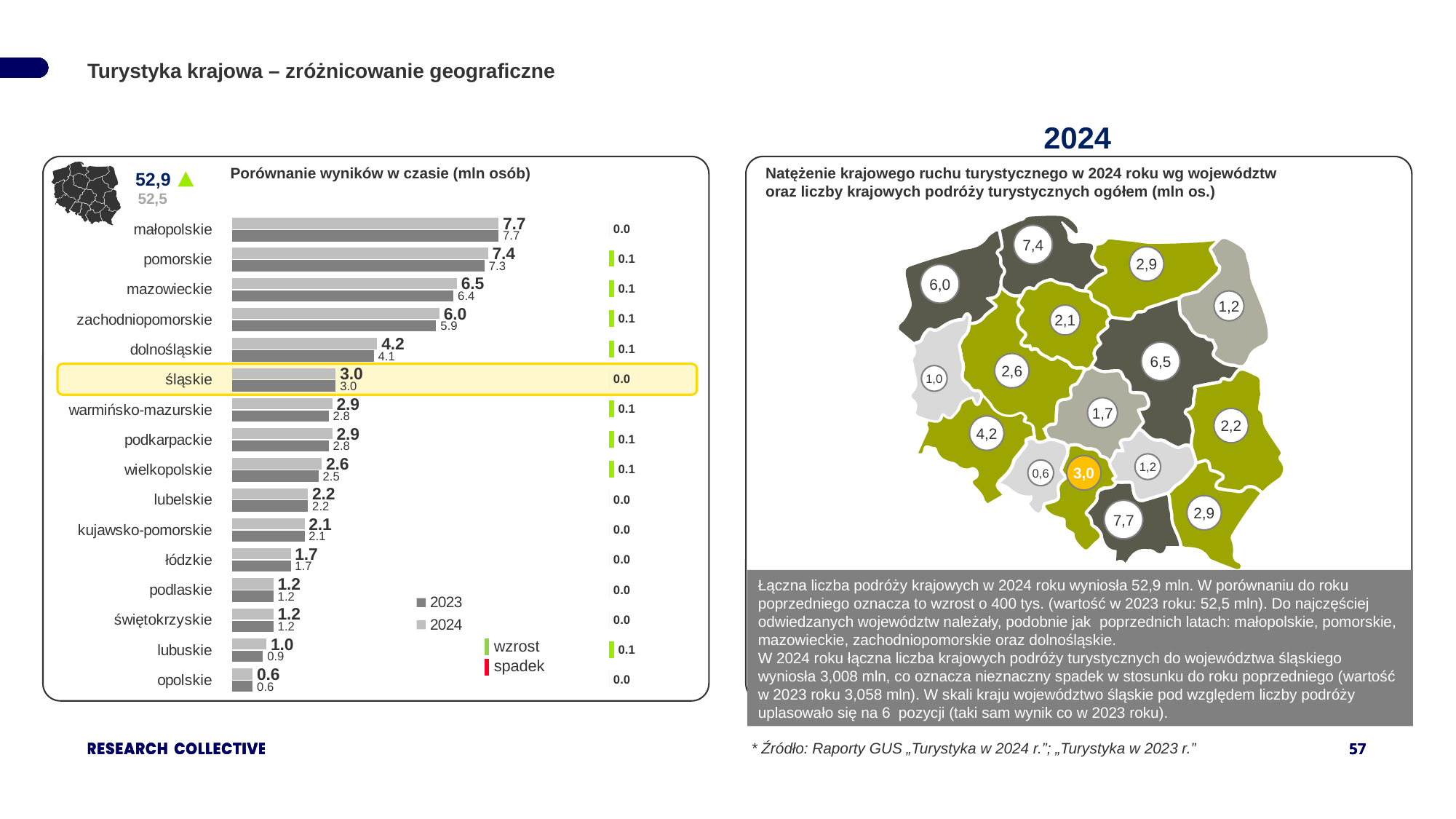
In the bar chart 'Porównanie wyników w czasie (mln osób)', what is the 2024 value for dolnośląskie? 4.2 In the bar chart 'Porównanie wyników w czasie (mln osób)', which voivodeship has the lowest 2024 value? opolskie On the map on the right, what value is shown in the orange-highlighted region? 3,0 In the bar chart 'Porównanie wyników w czasie (mln osób)', what is the 2023 value for zachodniopomorskie? 5.9 In the bar chart 'Porównanie wyników w czasie (mln osób)', what is the difference between the 2024 and 2023 values for lubuskie? 0.1 How many series does the legend of the bar chart 'Porównanie wyników w czasie (mln osób)' list? 2 In the bar chart 'Porównanie wyników w czasie (mln osób)', which voivodeship has the highest 2024 value? małopolskie What kind of chart is 'Porównanie wyników w czasie (mln osób)'? bar chart In the bar chart 'Porównanie wyników w czasie (mln osób)', what is the 2024 value for pomorskie? 7.4 In the bar chart 'Porównanie wyników w czasie (mln osób)', which is larger: the 2024 value for wielkopolskie or the 2024 value for lubelskie? wielkopolskie How many voivodeships are listed in the bar chart 'Porównanie wyników w czasie (mln osób)'? 16 In the bar chart 'Porównanie wyników w czasie (mln osób)', what is the difference between the 2024 values for małopolskie and mazowieckie? 1.2